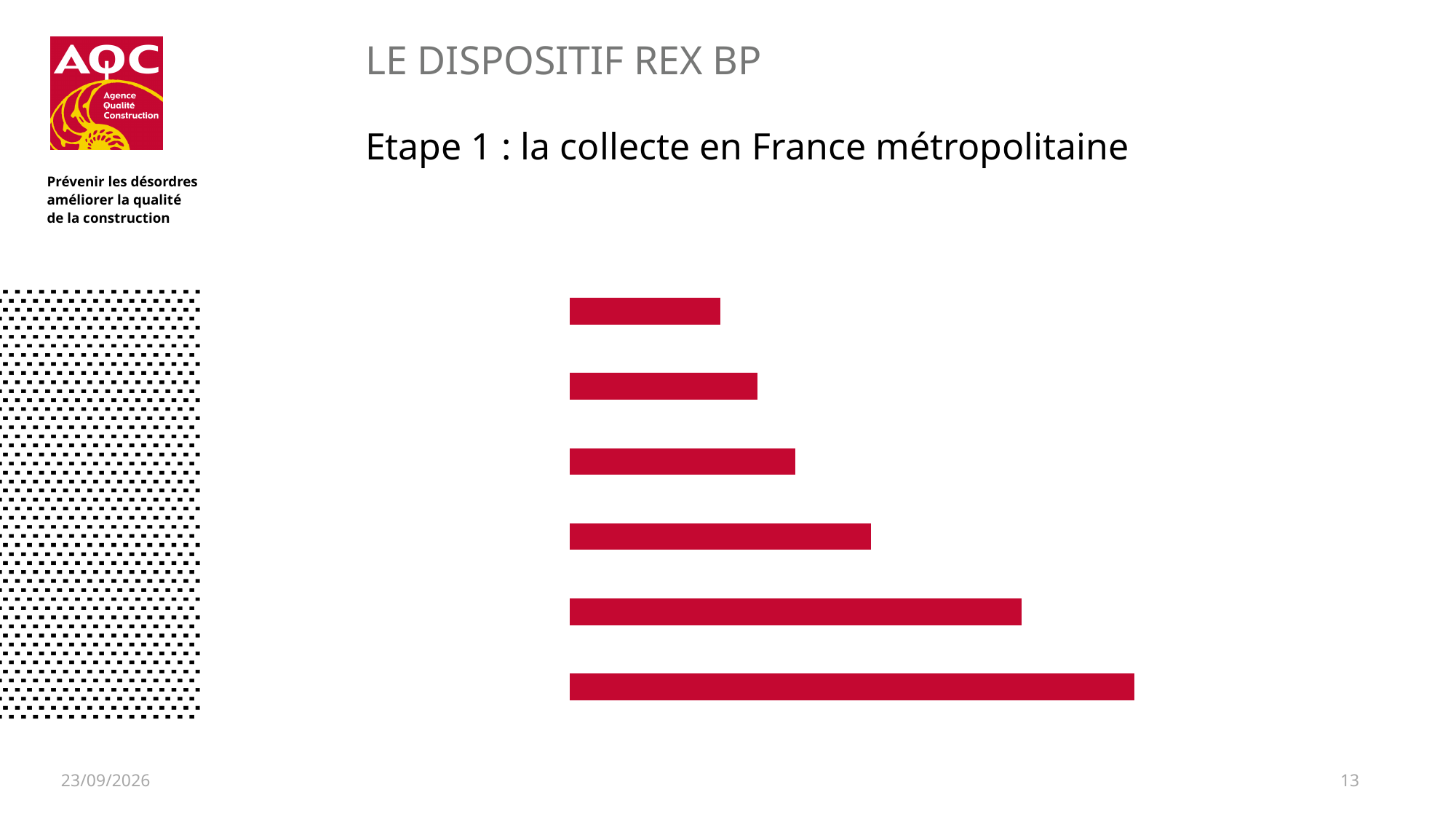
Which bar in the chart is the longest, the top one or the bottom one? the bottom one Do the bar lengths increase or decrease going from the top bar to the bottom bar? increase Which bar in the chart is the shortest, the top one or the bottom one? the top one What kind of chart is shown on the slide? bar chart Are the bars in the chart oriented horizontally or vertically? horizontally What colour are the bars in the chart? red Which is longer, the second bar from the top or the fifth bar from the top? the fifth bar from the top How many bars does the chart on the slide contain? 6 Which is longer, the third bar from the top or the fourth bar from the top? the fourth bar from the top